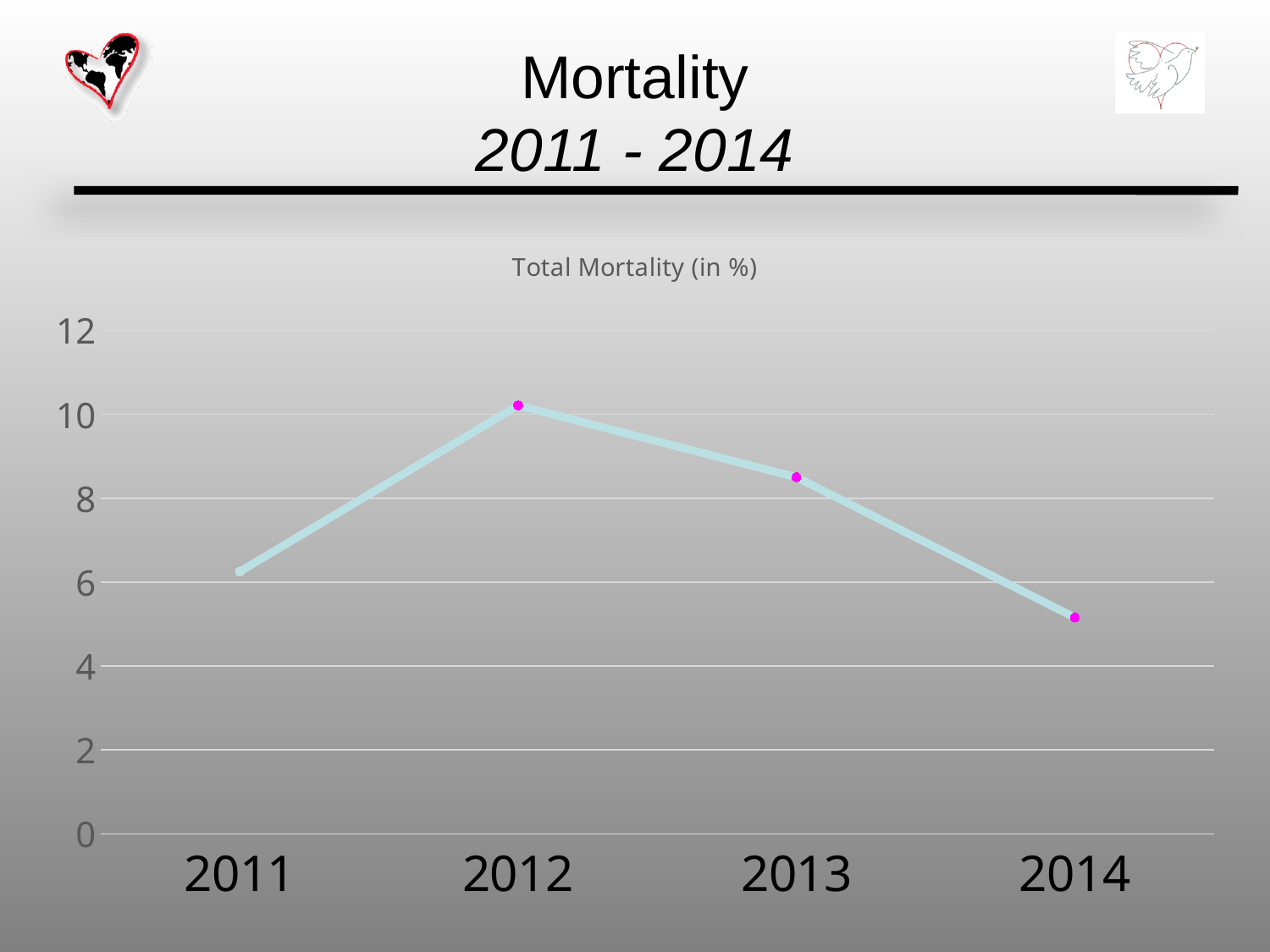
How many years are plotted on the x axis? 4 What kind of chart is shown on the slide? line chart Which year has the lowest total mortality? 2014 Is the value for 2012 greater or less than 8? greater Which year has the higher total mortality, 2011 or 2014? 2011 Which year has the highest total mortality? 2012 Is the value for 2011 greater or less than 8? less Is the value for 2013 greater or less than 8? greater What is the title of the chart? Total Mortality (in %) How does total mortality change from 2012 to 2014? it falls Which year has the higher total mortality, 2012 or 2013? 2012